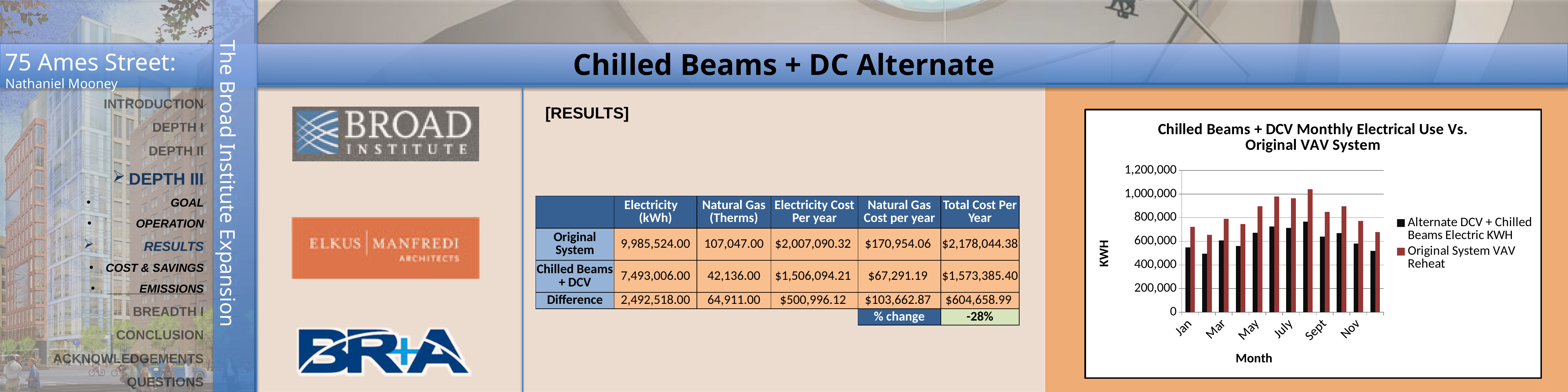
Is the value for Alternate DCV + Chilled Beams Electric KWH in July greater or less than 800,000? less Is the value for Alternate DCV + Chilled Beams Electric KWH in Sept greater or less than 800,000? less Is the value for Alternate DCV + Chilled Beams Electric KWH in Jan greater or less than 600,000? less What is the title of the chart? Chilled Beams + DCV Monthly Electrical Use Vs. Original VAV System How many series does the legend of the chart list? 2 What is the label on the vertical axis of the chart? KWH Which series has the higher value in every month shown on the chart? Original System VAV Reheat What kind of chart is shown on the slide? bar chart In Jan, which series has the larger value: Alternate DCV + Chilled Beams Electric KWH or Original System VAV Reheat? Original System VAV Reheat